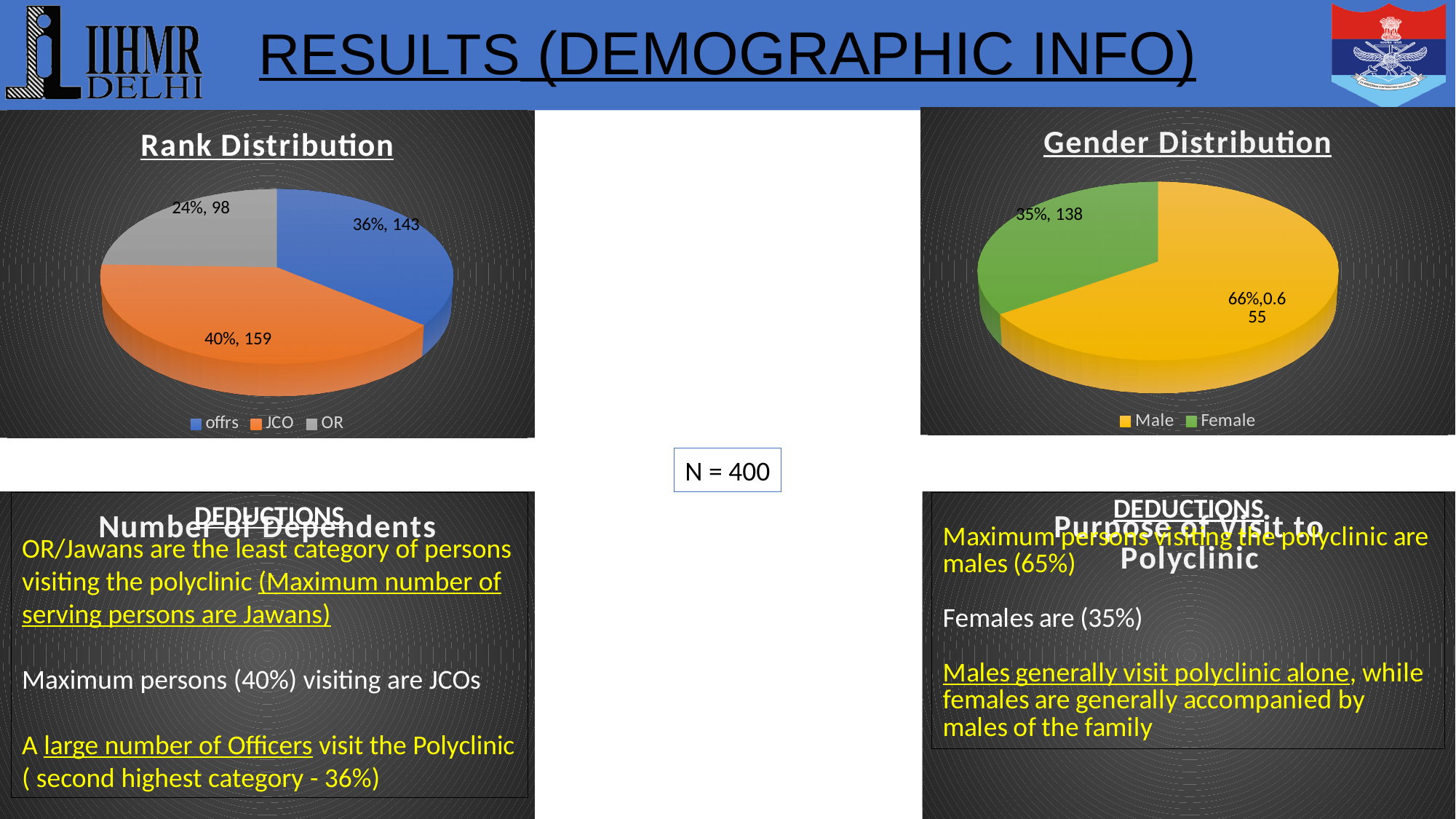
In the Rank Distribution chart, what share of the pie does OR represent? 24% In the Rank Distribution chart, which category has the largest slice? JCO In the Rank Distribution chart, what value is shown for OR? 98 In the Gender Distribution chart, what value is shown for Female? 138 In the Rank Distribution chart, what is the difference between the JCO value and the OR value? 61 In the Gender Distribution chart, which colour represents Female in the legend? Green What kind of chart is the Gender Distribution chart? Pie chart How many categories does the Rank Distribution chart show? 3 In the Gender Distribution chart, what share of the pie does Male represent? 66% In the Rank Distribution chart, which category has the smallest slice? OR In the Rank Distribution chart, what value is shown for JCO? 159 In the Rank Distribution chart, what value is shown for offrs? 143